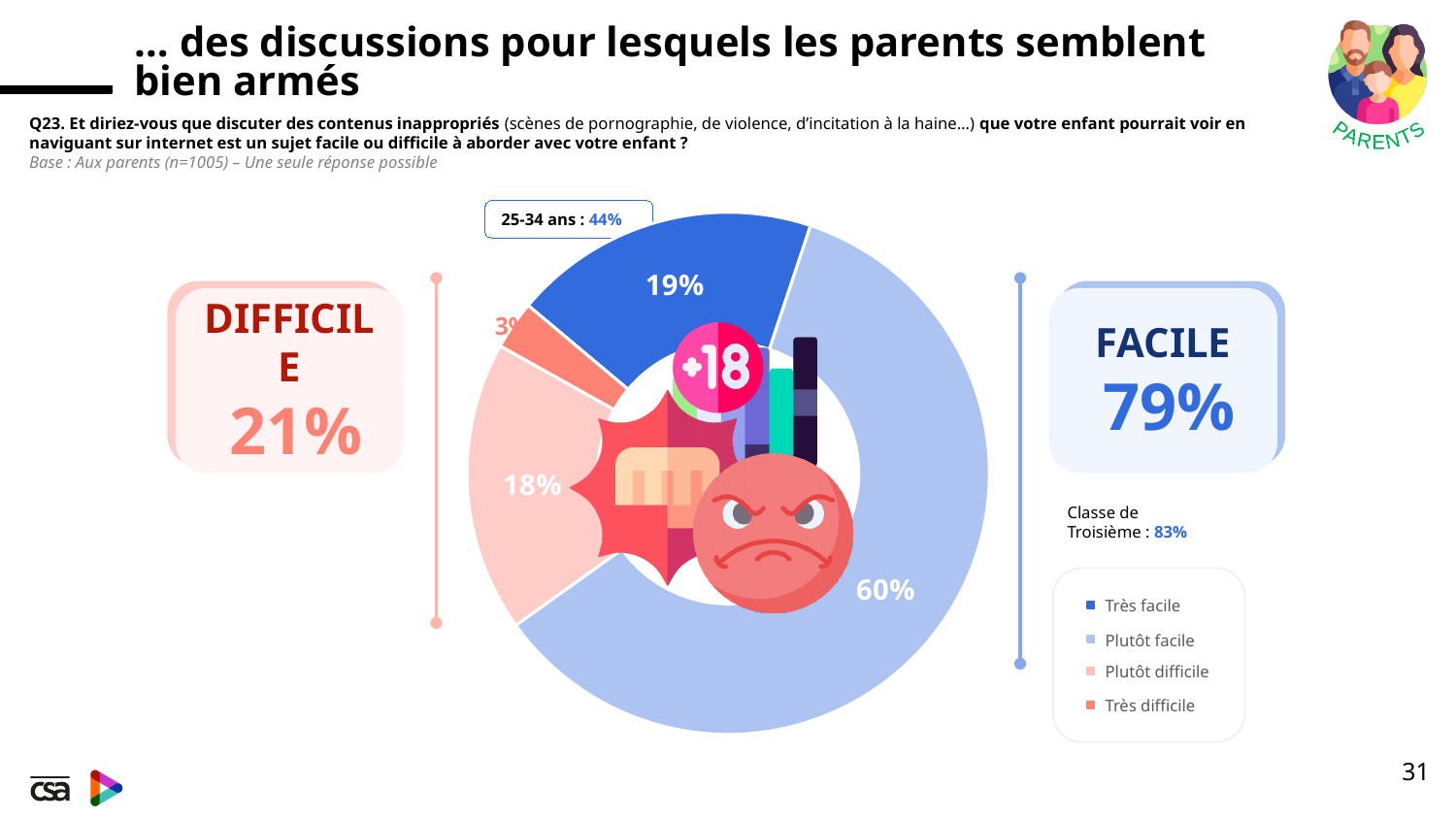
What kind of chart is shown on the slide? doughnut chart Which is larger, the share for "Très facile" or the share for "Plutôt difficile"? Très facile What is the difference between the "Plutôt facile" share and the "Très facile" share? 41 points What combined percentage is shown in the "FACILE" box? 79% Which response category has the largest share of the pie? Plutôt facile What percentage of parents answered "Plutôt facile"? 60% What percentage of parents answered "Très facile"? 19% What percentage is given for the "Classe de Troisième" callout? 83% What combined percentage is shown in the "DIFFICILE" box? 21% How many entries does the legend list? 4 Which response category has the smallest share of the pie? Très difficile What percentage of parents answered "Plutôt difficile"? 18%